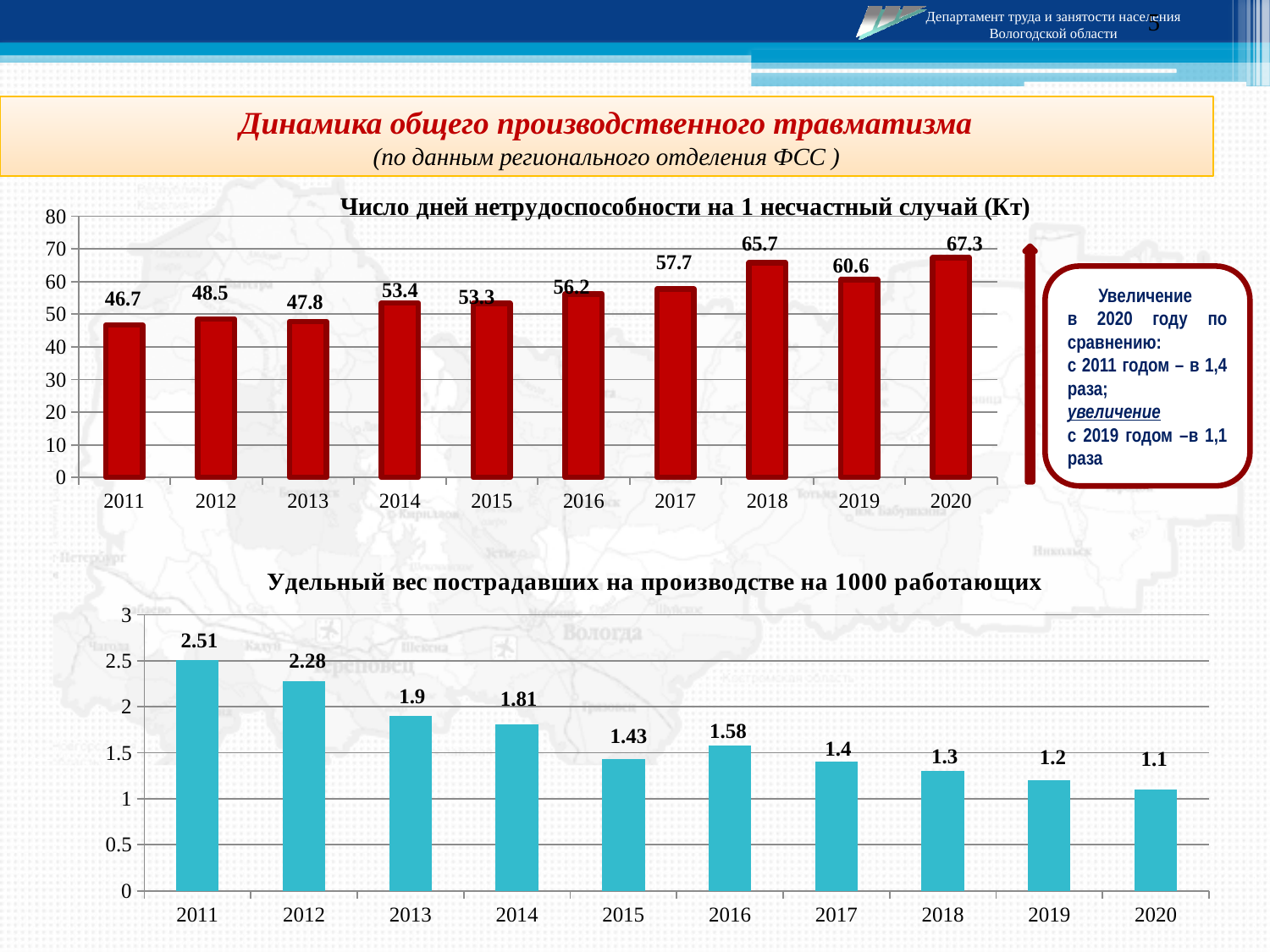
In the chart 'Удельный вес пострадавших на производстве на 1000 работающих', what is the value for 2015? 1.43 In the chart 'Удельный вес пострадавших на производстве на 1000 работающих', which year has the highest value? 2011 In the chart 'Удельный вес пострадавших на производстве на 1000 работающих', which is larger, the value for 2016 or the value for 2017? 2016 In the chart 'Число дней нетрудоспособности на 1 несчастный случай (Кт)', how many years are shown on the x axis? 10 In the chart 'Число дней нетрудоспособности на 1 несчастный случай (Кт)', what is the value for 2018? 65.7 In the chart 'Число дней нетрудоспособности на 1 несчастный случай (Кт)', what is the difference between the values for 2020 and 2019? 6.7 In the chart 'Число дней нетрудоспособности на 1 несчастный случай (Кт)', which year has the highest value? 2020 In the chart 'Число дней нетрудоспособности на 1 несчастный случай (Кт)', which year has the lowest value? 2011 In the chart 'Удельный вес пострадавших на производстве на 1000 работающих', do the values generally rise or fall from 2011 to 2020? fall In the chart 'Удельный вес пострадавших на производстве на 1000 работающих', which year has the lowest value? 2020 In the chart 'Число дней нетрудоспособности на 1 несчастный случай (Кт)', is the value for 2017 greater or less than 50? greater What type of chart is the bottom chart 'Удельный вес пострадавших на производстве на 1000 работающих'? bar chart